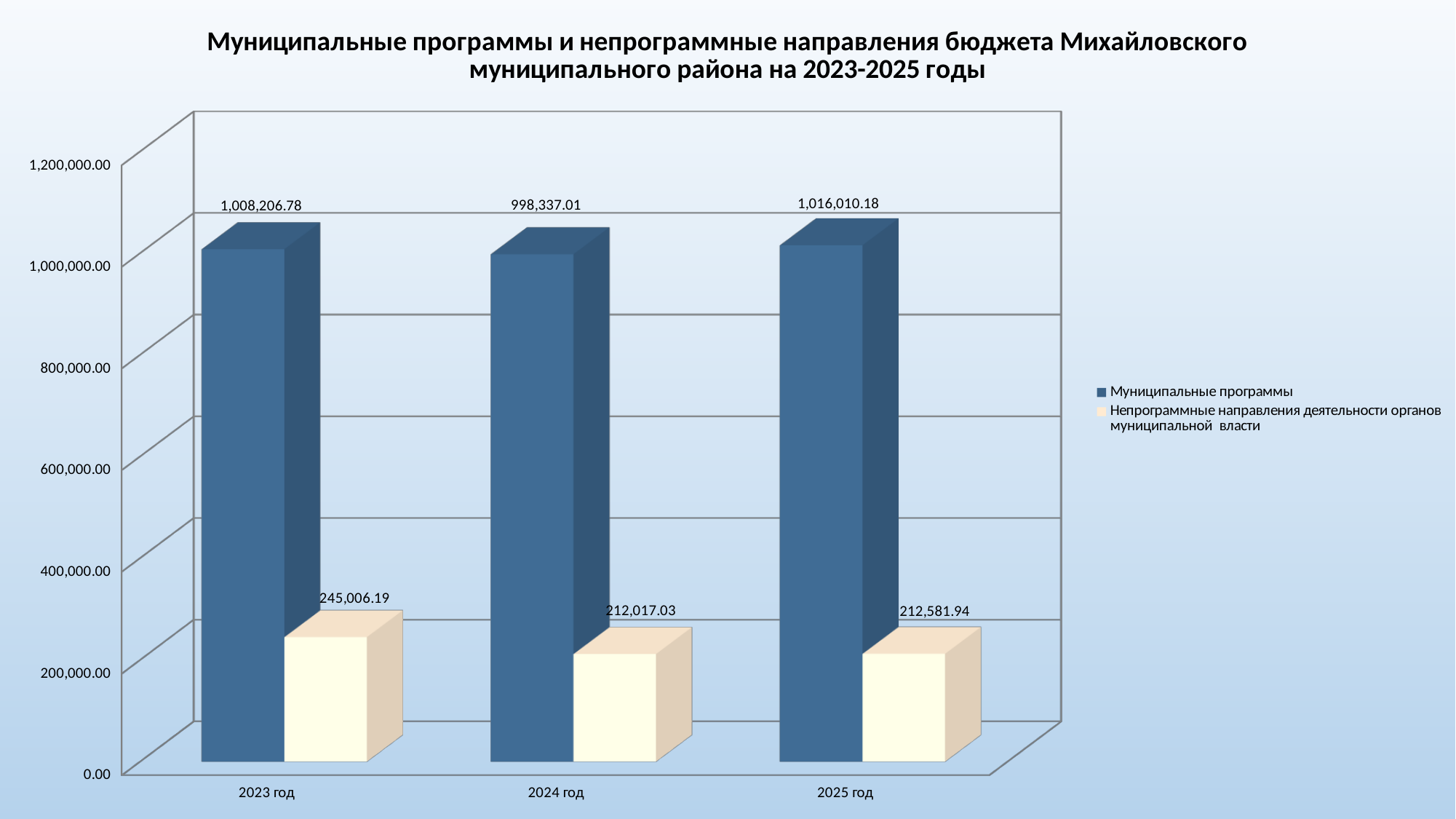
What is the value for Муниципальные программы in 2025 год? 1,016,010.18 How many years are shown on the x axis? 3 What kind of chart is shown on the slide? Bar chart In which year is the value for Непрограммные направления деятельности органов муниципальной власти the highest? 2023 год What is the value for Непрограммные направления деятельности органов муниципальной власти in 2025 год? 212,581.94 What is the difference between Муниципальные программы and Непрограммные направления деятельности органов муниципальной власти in 2023 год? 763,200.59 How many series does the legend list? 2 What is the value for Муниципальные программы in 2023 год? 1,008,206.78 In which year is the value for Муниципальные программы the highest? 2025 год In which year is the value for Муниципальные программы the lowest? 2024 год What is the value for Непрограммные направления деятельности органов муниципальной власти in 2024 год? 212,017.03 Which is larger in 2024 год: Муниципальные программы or Непрограммные направления деятельности органов муниципальной власти? Муниципальные программы